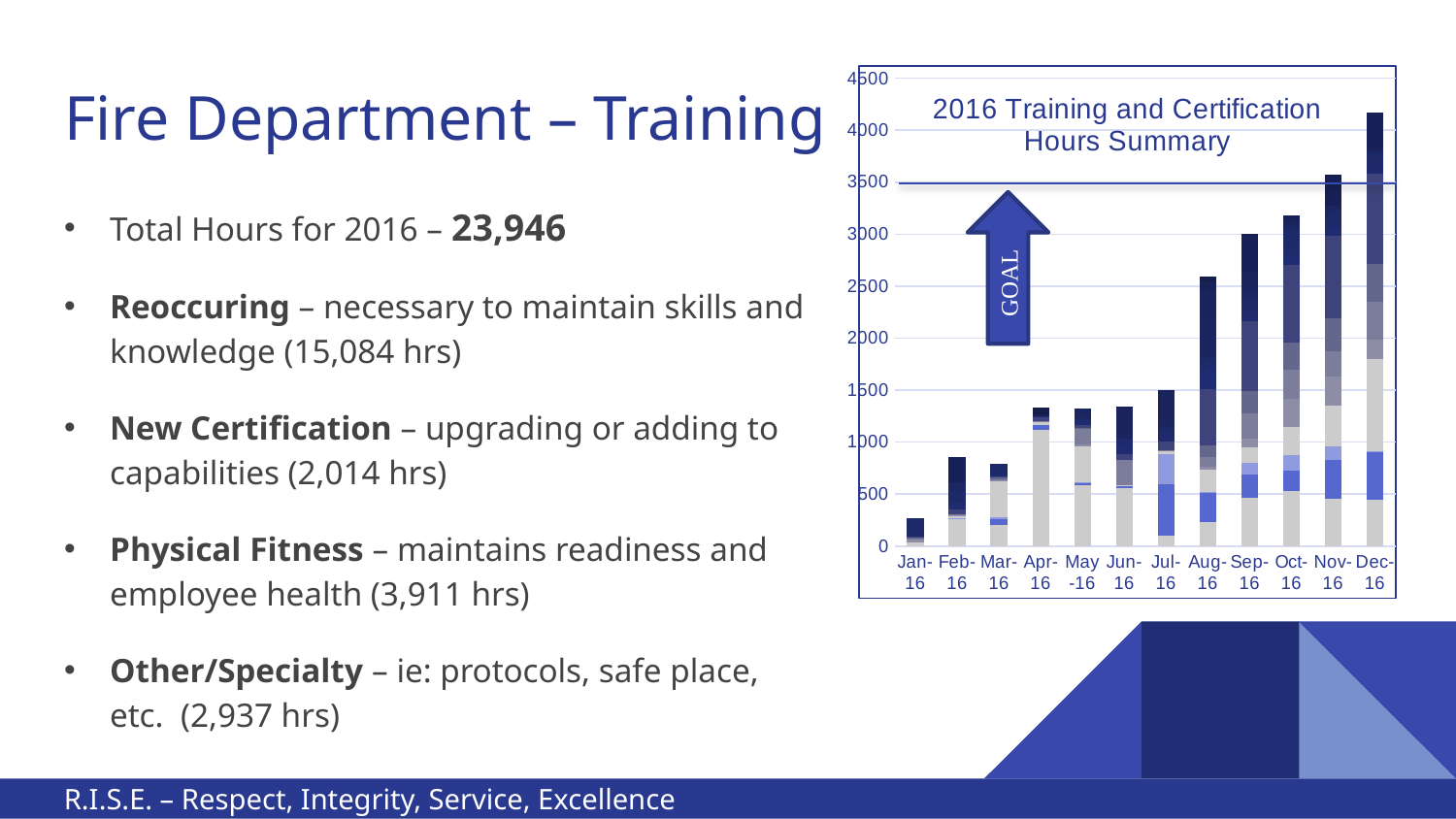
At what value on the y axis is the horizontal GOAL line drawn? 3500 Is the total value for Dec-16 greater or less than 4000? greater Which month has the shortest bar in the chart? Jan-16 Do the bar totals generally rise or fall from Jan-16 to Dec-16? rise Is the total value for Oct-16 greater or less than 3000? greater What kind of chart is shown on the slide? Stacked bar chart Which bar is taller, Aug-16 or Jul-16? Aug-16 Is the total value for Jan-16 greater or less than 500? less Which month has the tallest bar in the chart? Dec-16 What is the title of the chart? 2016 Training and Certification Hours Summary How many months are shown on the x axis of the chart? 12